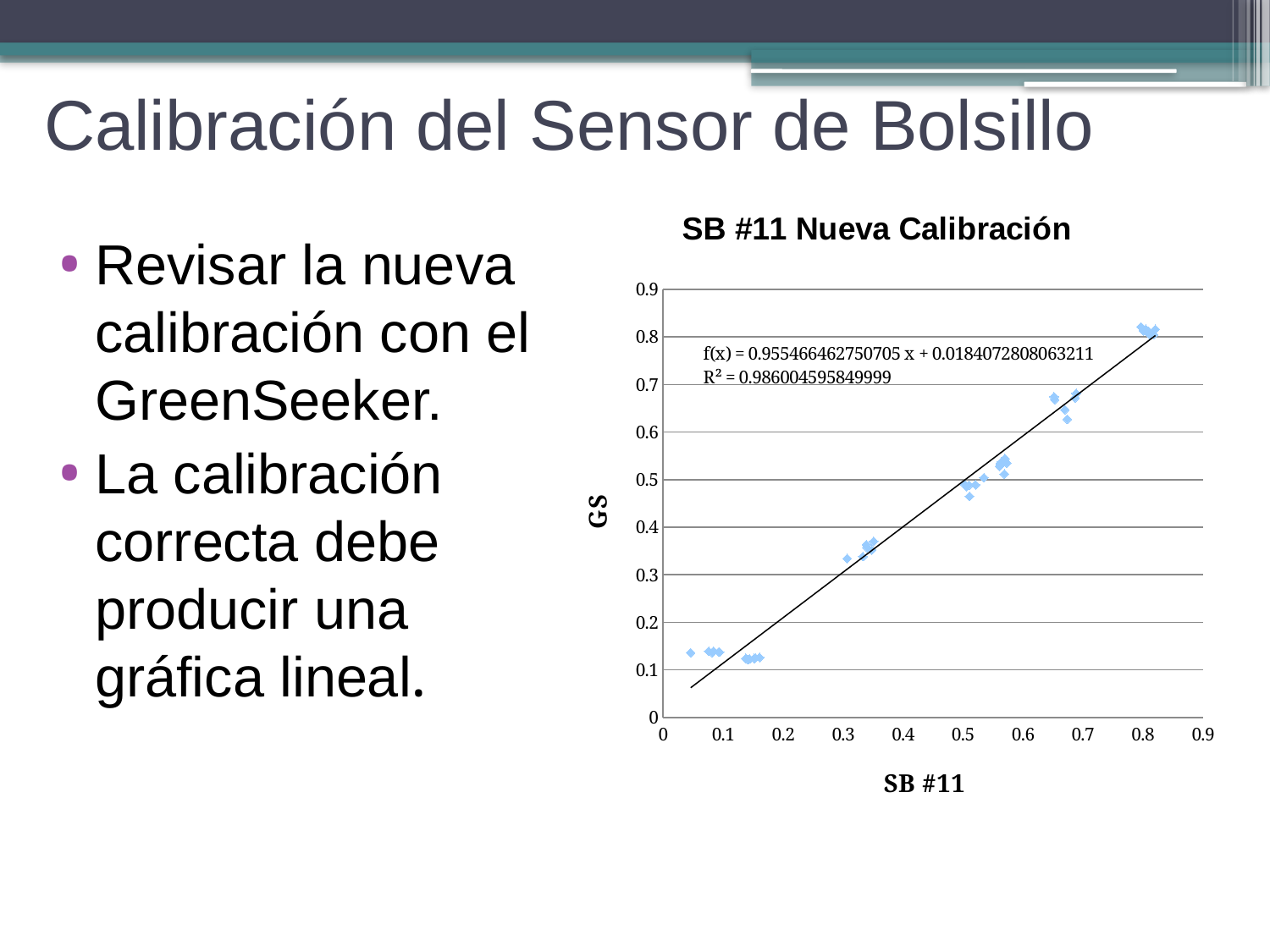
Do the GS values rise or fall as SB #11 increases along the x axis? rise Are the GS values for the points near SB #11 = 0.55 greater or less than 0.4? greater Which group of points has the higher GS values: those near SB #11 = 0.8 or those near SB #11 = 0.1? those near SB #11 = 0.8 What R² value is printed on the chart? 0.986004595849999 What is the title of the chart? SB #11 Nueva Calibración Are the GS values for the points near SB #11 = 0.5 greater or less than 0.6? less Are the GS values for the points near SB #11 = 0.65 to 0.7 greater or less than 0.6? greater What kind of chart is shown on the slide? scatter chart